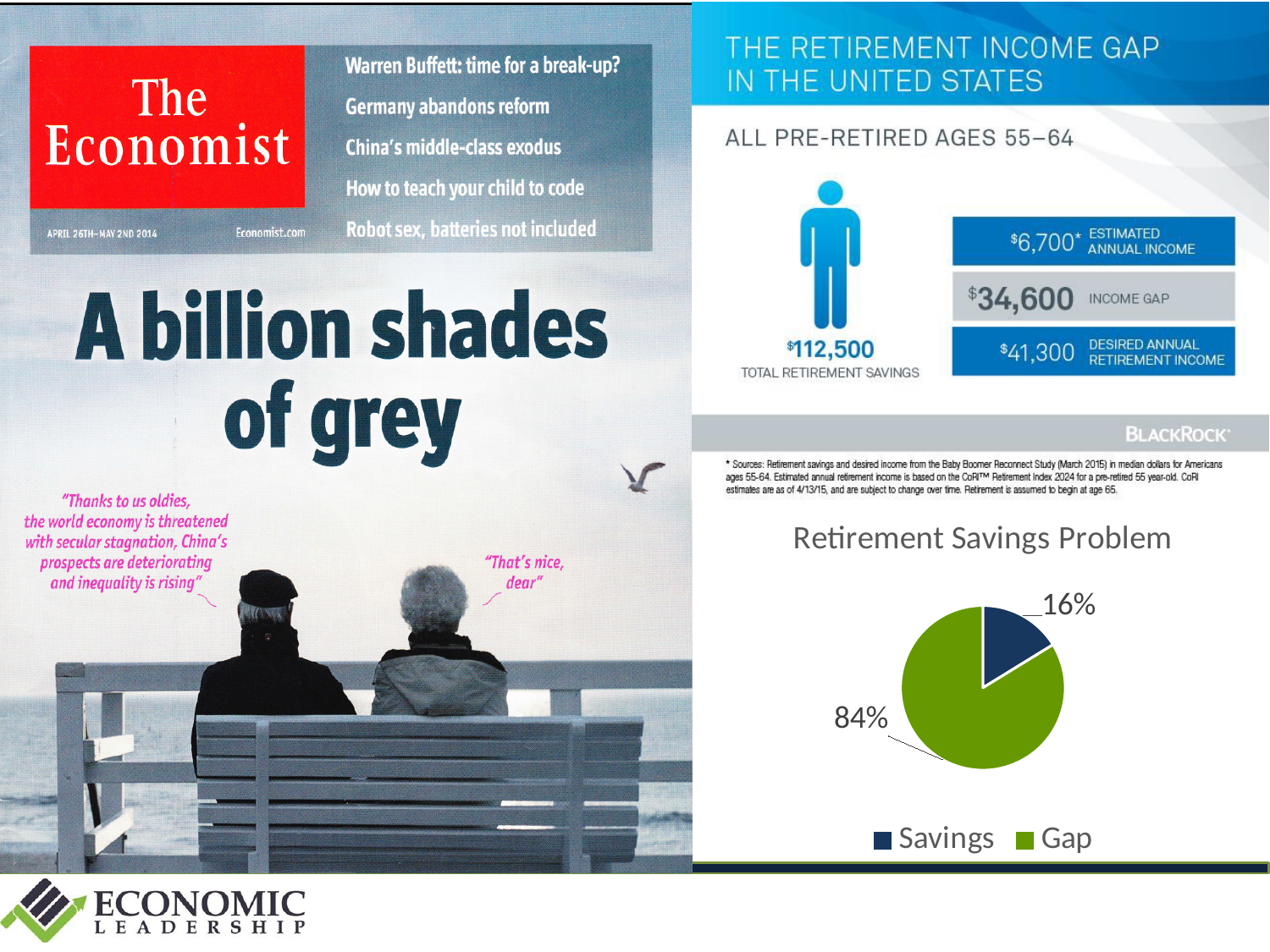
In the "Retirement Savings Problem" pie chart, which slice is the largest? Gap How many slices does the "Retirement Savings Problem" pie chart have? 2 In the "Retirement Savings Problem" pie chart, what colour is the Gap slice? green In the "Retirement Savings Problem" pie chart, which slice is the smallest? Savings In the "Retirement Savings Problem" pie chart, which is larger, Savings or Gap? Gap In the "Retirement Savings Problem" pie chart, what is the difference in percentage points between the Gap and Savings slices? 68 What kind of chart is "Retirement Savings Problem"? pie chart How many entries does the legend of the "Retirement Savings Problem" pie chart list? 2 In the "Retirement Savings Problem" pie chart, what share does the Savings slice represent? 16% What is the title of the pie chart on the slide? Retirement Savings Problem In the "Retirement Savings Problem" pie chart, what share does the Gap slice represent? 84%